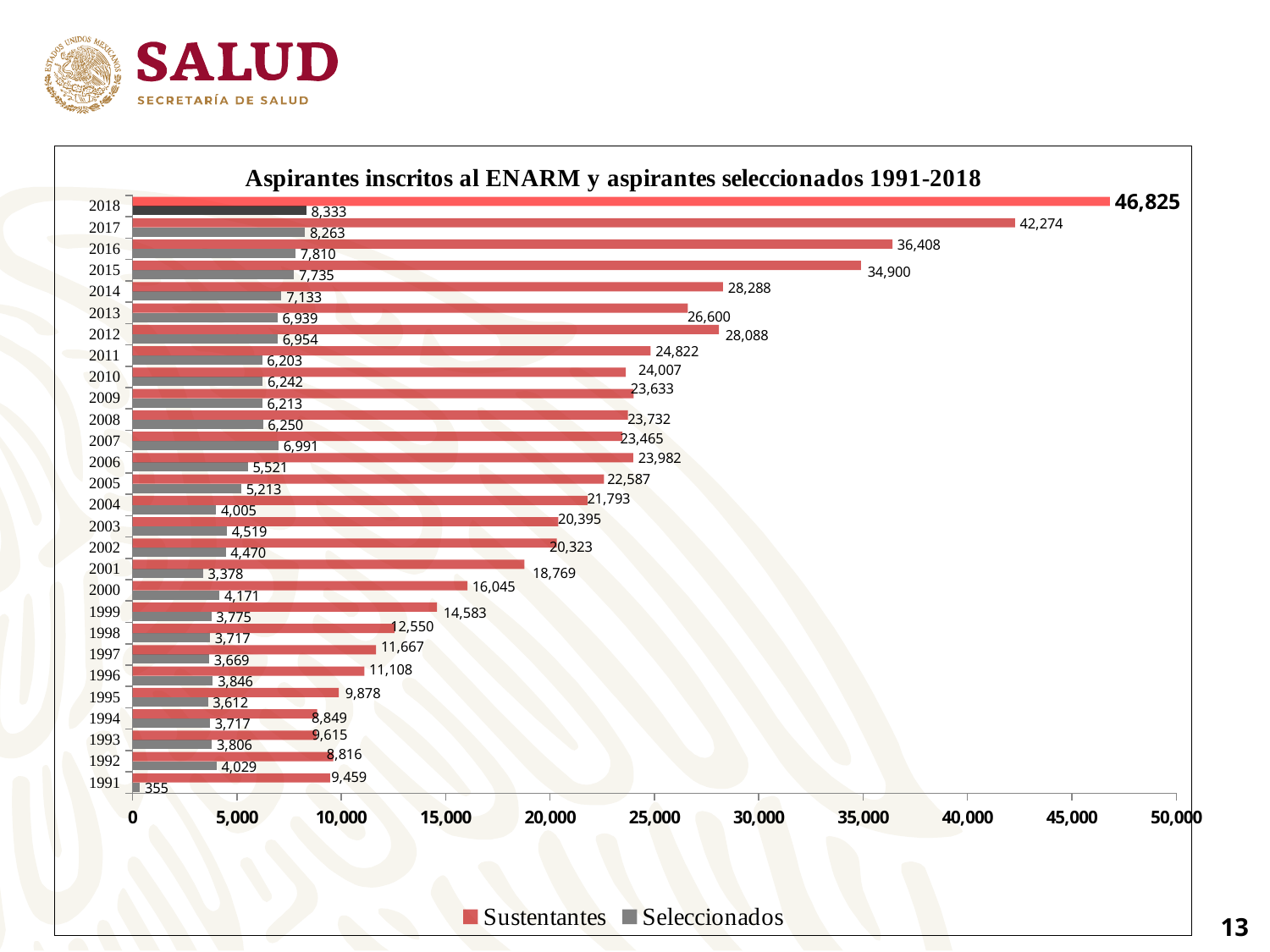
How many years are shown on the chart? 28 What is the difference between Sustentantes and Seleccionados in 2018? 38,492 What is the Sustentantes value for 2018? 46,825 Which year had more Sustentantes, 2012 or 2013? 2012 Which year has the highest Sustentantes value? 2018 What is the Sustentantes value for 2000? 16,045 How many series does the legend list? 2 What is the title of the chart? Aspirantes inscritos al ENARM y aspirantes seleccionados 1991-2018 What is the Seleccionados value for 2015? 7,735 What kind of chart is shown on the slide? Bar chart Do the Sustentantes values generally rise or fall from 1991 to 2018? Rise Which year has the lowest Seleccionados value? 1991